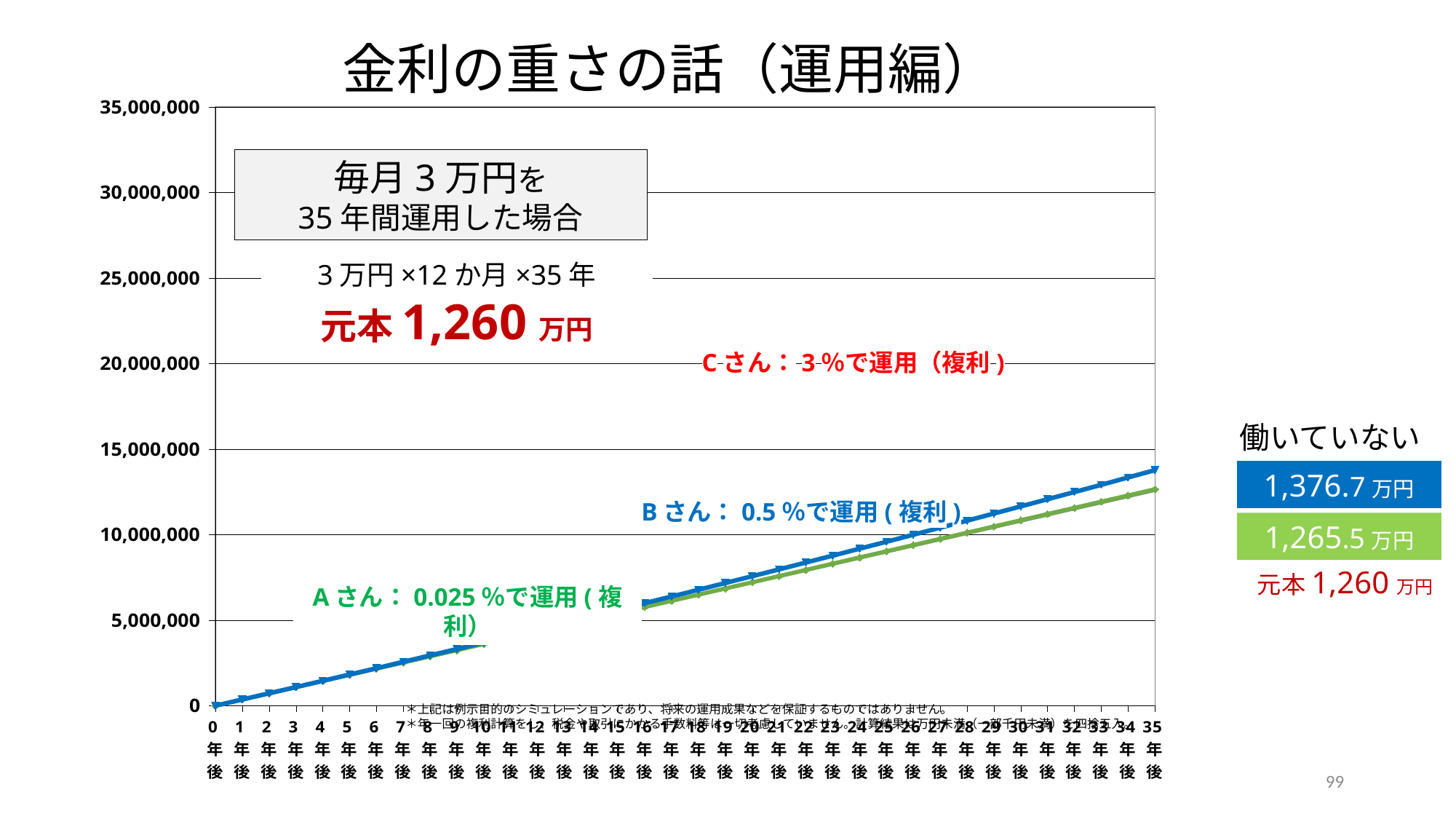
Do the plotted lines rise or fall as the years increase along the x axis? rise What kind of chart is shown on the slide? line chart What final amount is shown in the blue box to the right of the chart? 1,376.7万円 At 35年後, which line is higher: the blue line (Bさん) or the green line (Aさん)? the blue line (Bさん) What final amount is shown in the green box to the right of the chart? 1,265.5万円 Is the value of the blue line (Bさん: 0.5%で運用) at 35年後 greater or less than 15,000,000? less How many year points are labelled on the x axis, from 0年後 to 35年後? 36 Is the value of the green line (Aさん: 0.025%で運用) at 10年後 greater or less than 5,000,000? less What is the title of the slide? 金利の重さの話（運用編） What is the highest value shown on the y axis? 35,000,000 Is the value of the blue line (Bさん: 0.5%で運用) at 35年後 greater or less than 10,000,000? greater